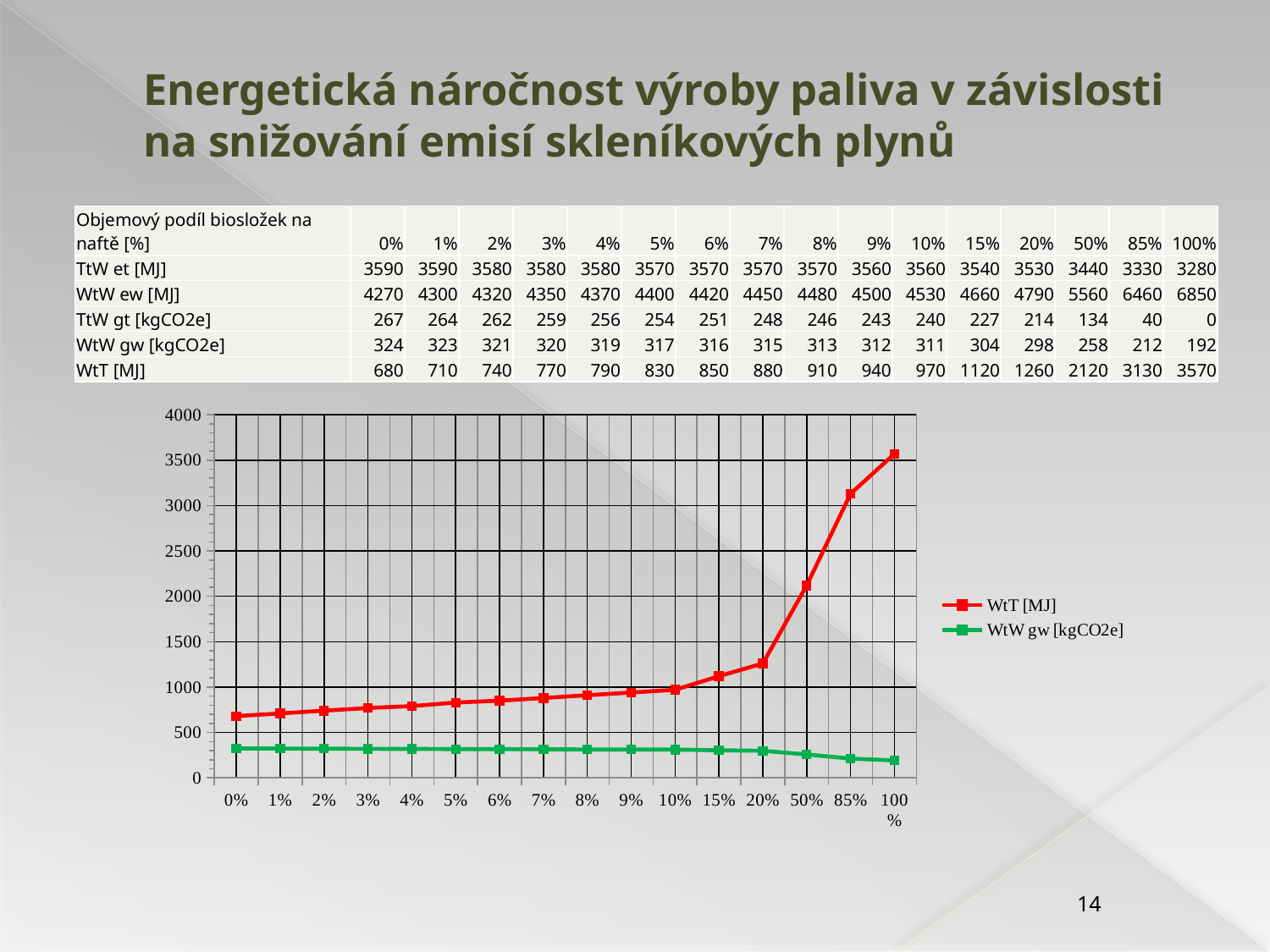
According to the table, what is the WtW gw [kgCO2e] value at 0%? 324 Which series has the larger value at 50%, WtT [MJ] or WtW gw [kgCO2e]? WtT [MJ] What kind of chart is shown on the slide? line chart How many categories are shown along the x axis of the chart? 16 At which x-axis category is the WtT [MJ] series highest? 100% What is the difference between the WtT [MJ] value at 100% and at 0%, using the table values? 2890 Is the WtT [MJ] value at 85% greater or less than 3000? greater According to the table, what is the WtT [MJ] value at 100%? 3570 What colour is the WtT [MJ] line in the chart? red Does the WtW gw [kgCO2e] series rise or fall along the x axis? fall At which x-axis category is the WtW gw [kgCO2e] series lowest? 100% How many series does the chart legend list? 2